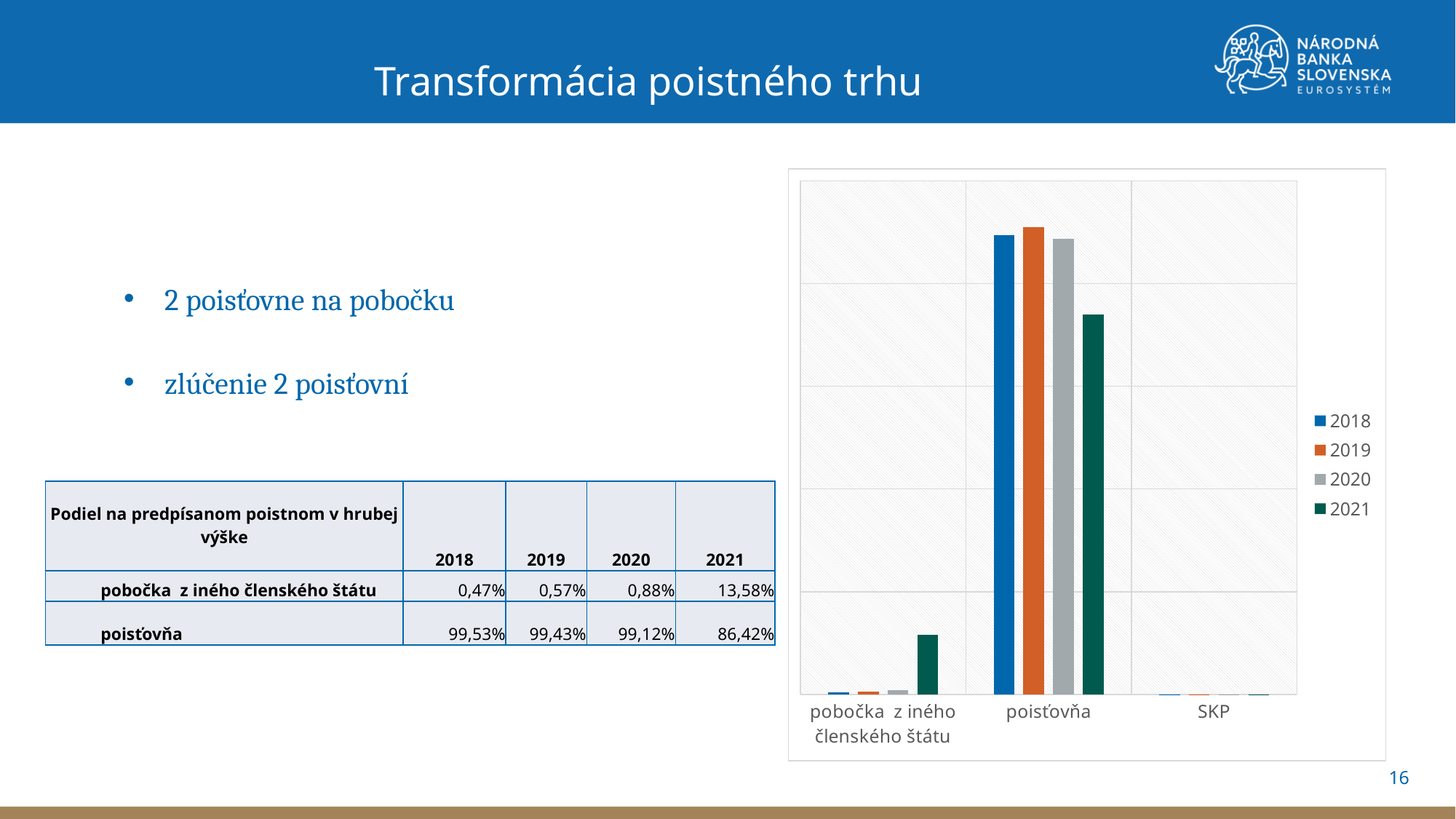
How many series does the chart legend list? 4 Do the bars for pobočka z iného členského štátu rise or fall from 2018 to 2021? rise For pobočka z iného členského štátu, is the bar for 2020 or 2021 larger? 2021 Which category has the tallest bars in the chart? poisťovňa Which series is shown in dark green in the chart legend? 2021 For the category poisťovňa, which year has the lowest bar? 2021 For poisťovňa, is the bar for 2018 or 2021 larger? 2018 Which category has the smallest bars in the chart? SKP How many categories are shown on the x axis of the chart? 3 What kind of chart is shown on the slide? bar chart Which series is shown in blue in the chart legend? 2018 For the category pobočka z iného členského štátu, which year has the highest bar? 2021